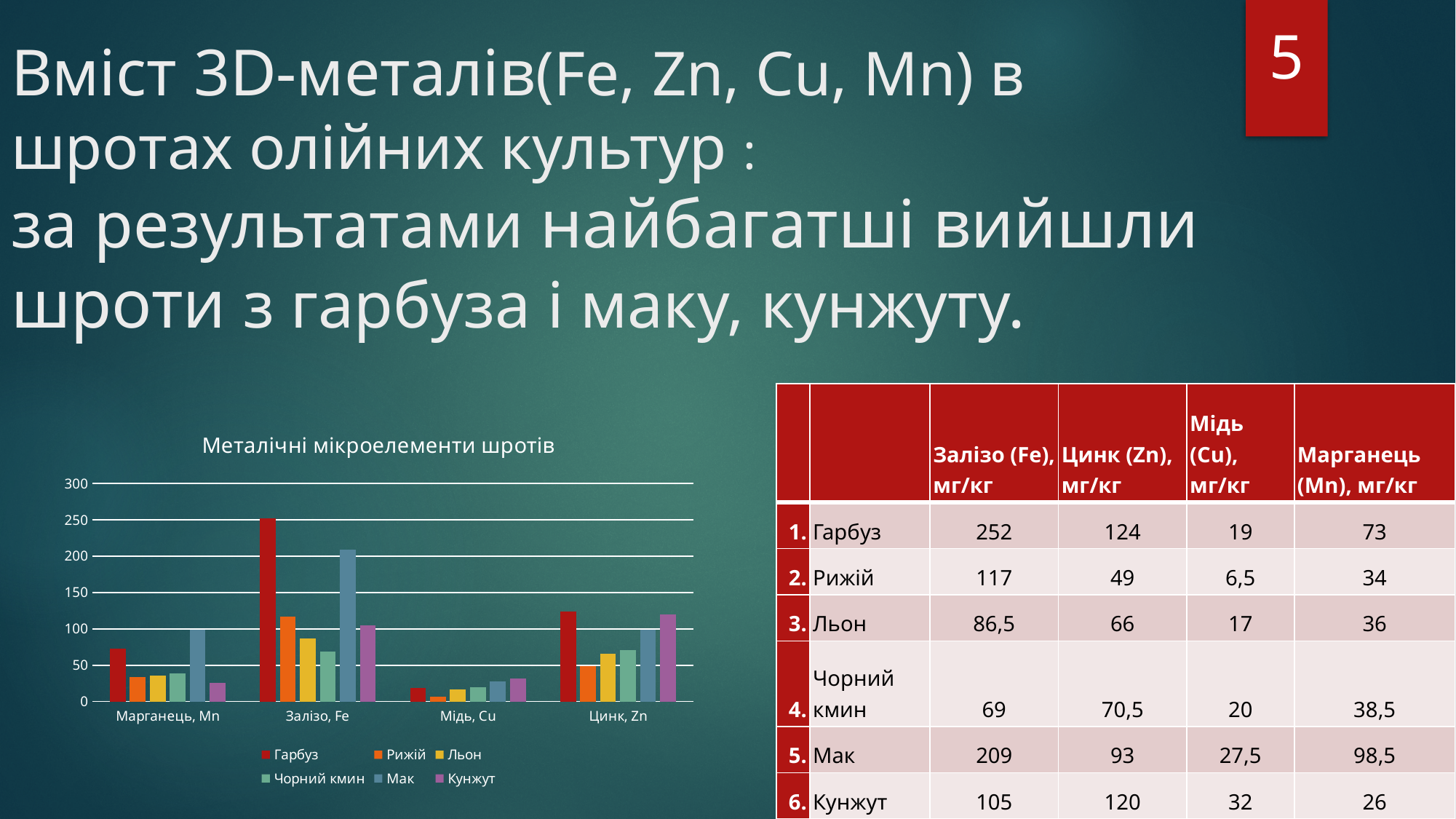
Is the value for Мак in the Залізо, Fe category greater or less than 200? greater How many categories are shown on the x axis of the chart? 4 What is the title of the chart? Металічні мікроелементи шротів In the Марганець, Mn category, which is larger: Мак or Кунжут? Мак How many series does the chart legend list? 6 In the Цинк, Zn category, which is larger: Гарбуз or Мак? Гарбуз Is the value for Гарбуз in the Марганець, Mn category greater or less than 50? greater What is the value for Гарбуз in the Залізо, Fe category? 252 What kind of chart is shown on the slide? bar chart In the Залізо, Fe category, which series has the highest bar? Гарбуз What is the difference between Гарбуз and Мак in the Залізо, Fe category? 43 In the Мідь, Cu category, which series has the lowest bar? Рижій